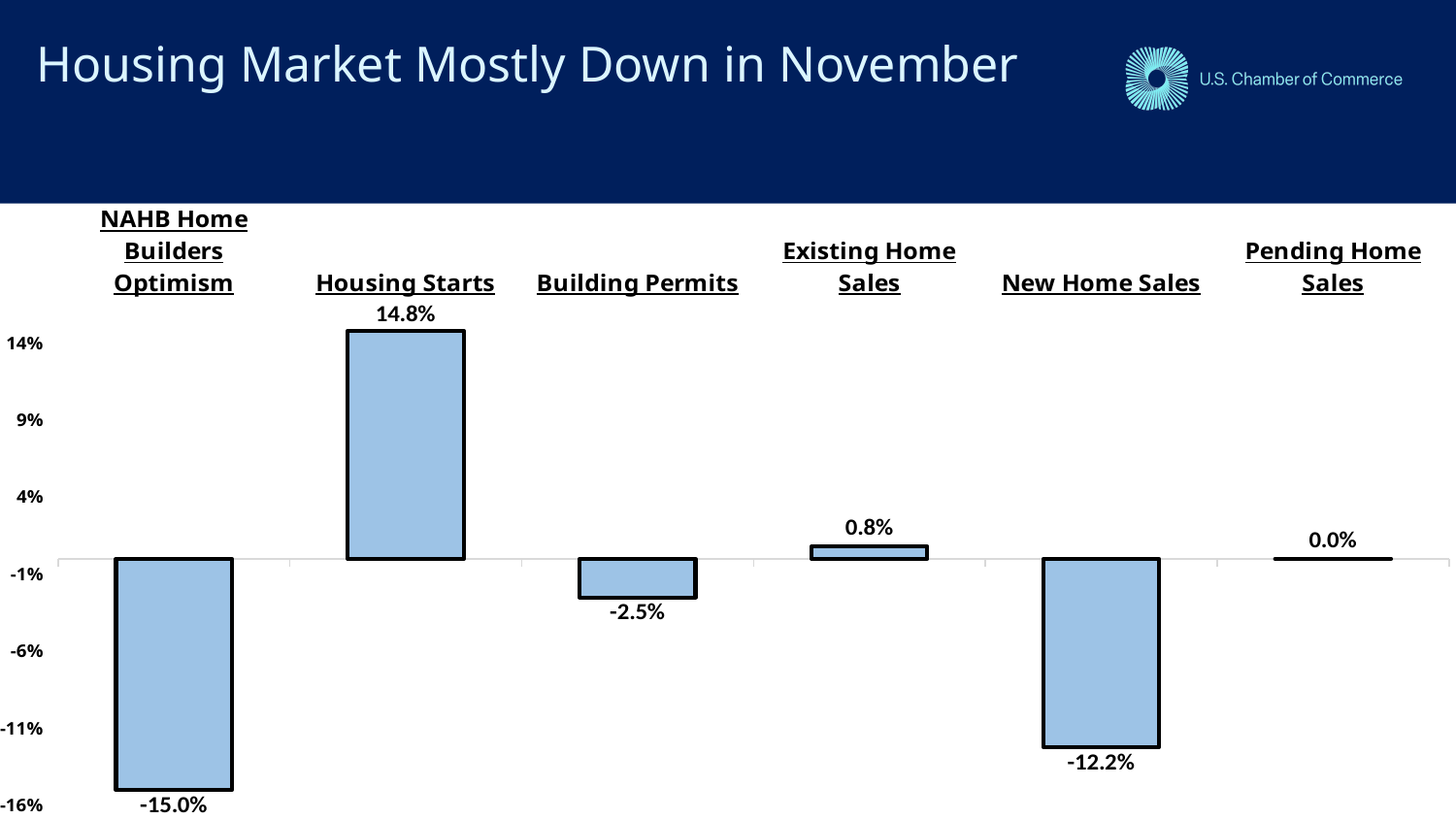
What is the value for Building Permits? -2.5% How many categories are shown in the chart? 6 What is the value for NAHB Home Builders Optimism? -15.0% What is the value for Pending Home Sales? 0.0% What kind of chart is shown on the slide? Bar chart What is the title of the slide? Housing Market Mostly Down in November Which category has the highest value? Housing Starts What is the difference between the values for Housing Starts and Existing Home Sales? 14.0% Which category has the lowest value? NAHB Home Builders Optimism Which is larger, the value for Building Permits or the value for New Home Sales? Building Permits What is the value for Housing Starts? 14.8% What is the value for New Home Sales? -12.2%